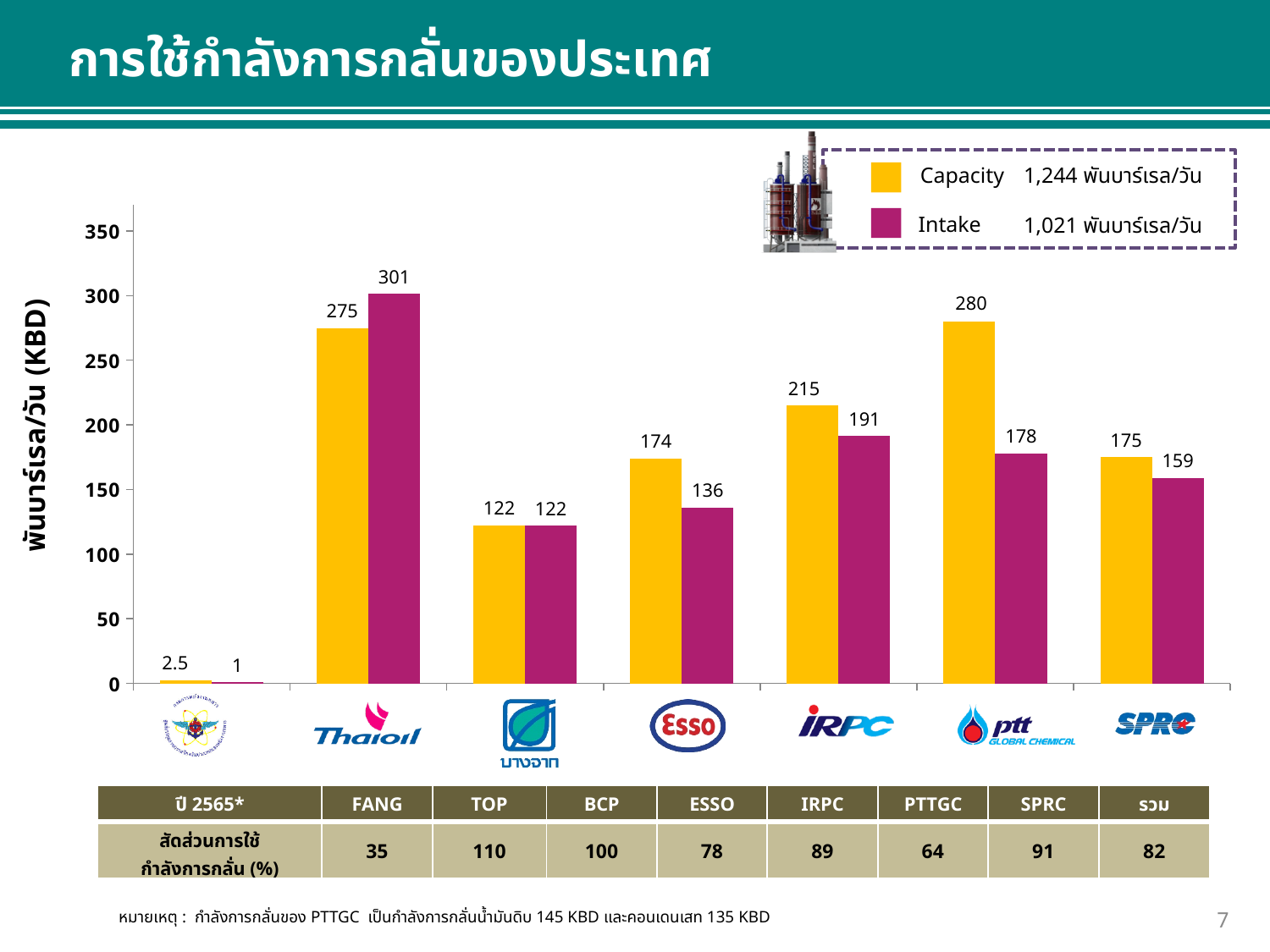
How many series does the legend list? 2 What total Capacity value is shown in the legend box? 1,244 พันบาร์เรล/วัน Which refinery has the highest Intake value? Thaioil (TOP) How many refineries (categories) are shown on the x axis? 7 What is the Capacity value for PTTGC? 280 What kind of chart is shown on the slide? Bar chart What is the difference between Capacity and Intake for IRPC? 24 What is the Intake value for ESSO? 136 Which is larger for Thaioil (TOP), Capacity or Intake? Intake Which refinery has the lowest Capacity value? FANG What is the Intake value for Thaioil (TOP)? 301 What is the difference between Capacity and Intake for PTTGC? 102